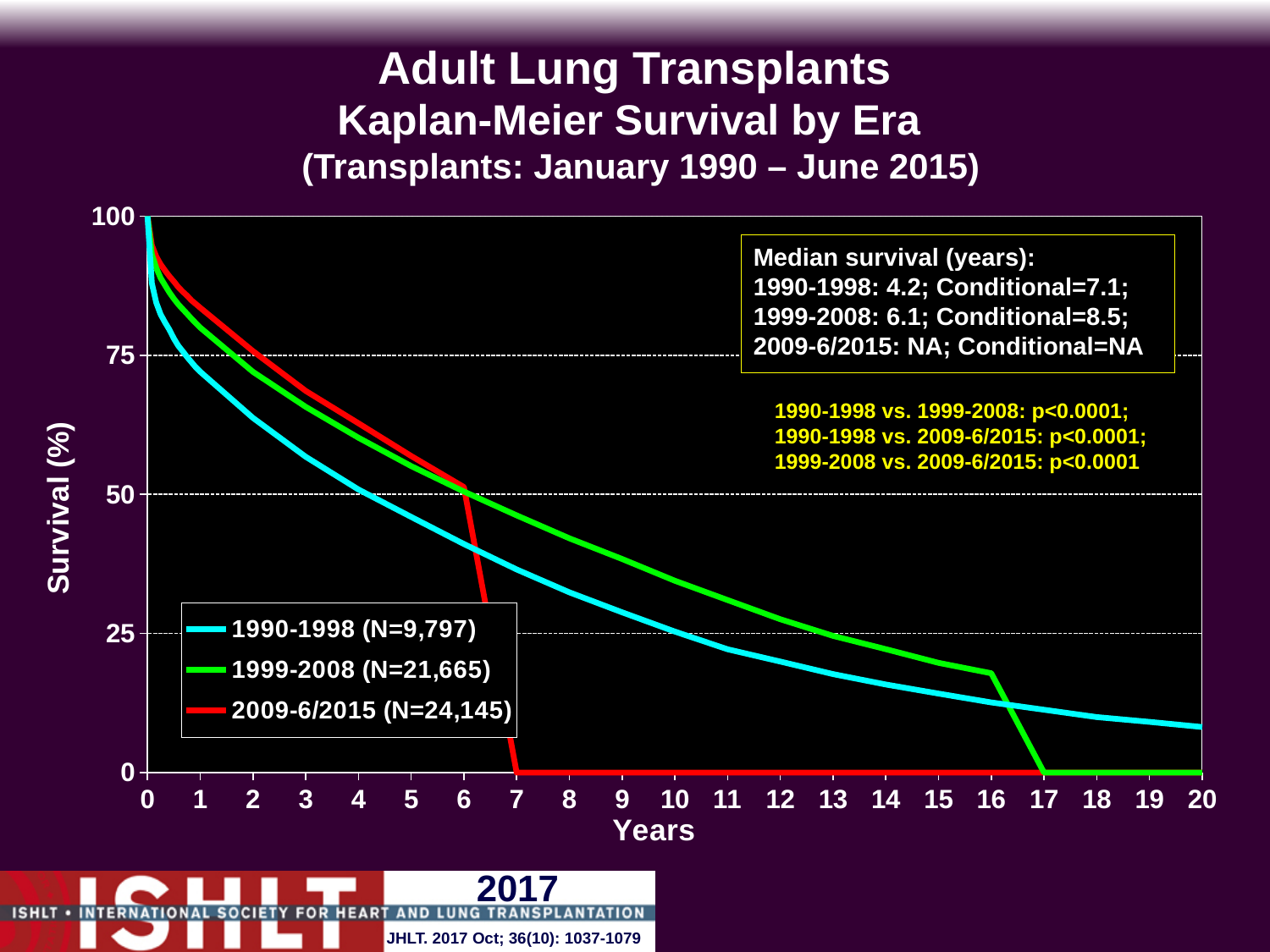
Which era has the largest number of transplants (N) in the legend? 2009-6/2015 (N=24,145) Is the survival for the 1999-2008 era at 10 years greater or less than 25? greater Is the survival for the 2009-6/2015 era at 3 years greater or less than 50? greater At 5 years, which era has higher survival, 1990-1998 or 1999-2008? 1999-2008 What is the number of transplants (N) for the 1999-2008 era shown in the legend? 21,665 Do the survival curves rise or fall as years increase? fall Is the survival for the 1990-1998 era at 5 years greater or less than 50? less What kind of chart is shown on the slide? line chart What colour is the line for the 2009-6/2015 era? red What is the conditional median survival in years for the 1999-2008 era? 8.5 How many series does the legend list? 3 What is the median survival in years for the 1990-1998 era? 4.2